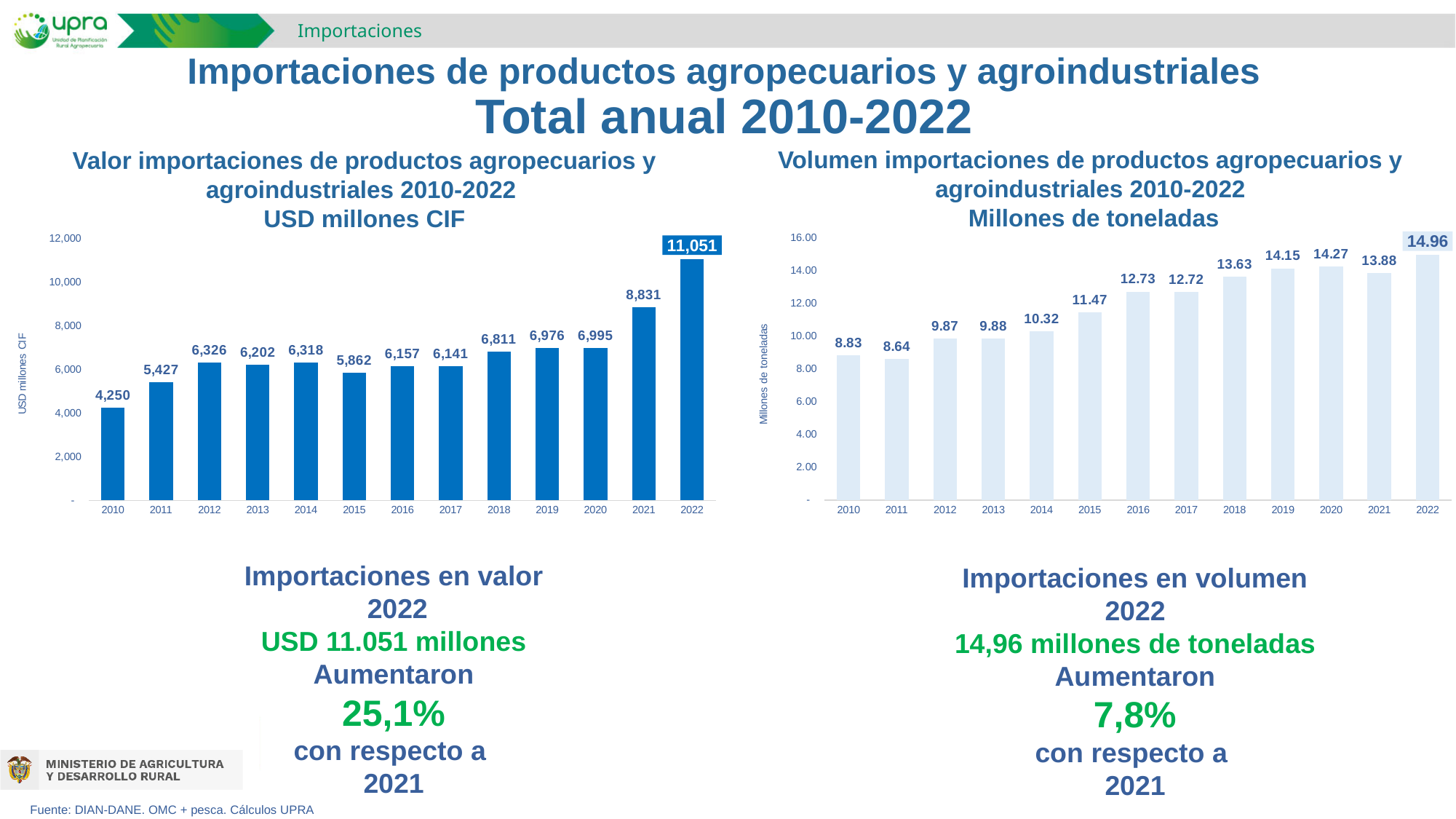
In the left chart (Valor importaciones, USD millones CIF), how many years are plotted? 13 In the left chart (Valor importaciones, USD millones CIF), which year has the lowest value? 2010 In the right chart (Volumen importaciones, Millones de toneladas), which is larger, the value for 2020 or the value for 2021? 2020 In the right chart (Volumen importaciones, Millones de toneladas), which year has the lowest value? 2011 In the right chart (Volumen importaciones, Millones de toneladas), what is the difference between the values for 2022 and 2021? 1.08 What kind of chart is the right chart (Volumen importaciones, Millones de toneladas)? Bar chart In the left chart (Valor importaciones, USD millones CIF), what is the difference between the values for 2022 and 2021? 2,220 In the left chart (Valor importaciones, USD millones CIF), which year has the highest value? 2022 In the right chart (Volumen importaciones, Millones de toneladas), do the values generally rise or fall from 2010 to 2022? Rise In the left chart (Valor importaciones, USD millones CIF), which is larger, the value for 2012 or the value for 2015? 2012 In the right chart (Volumen importaciones, Millones de toneladas), what is the value for 2016? 12.73 In the left chart (Valor importaciones, USD millones CIF), what is the value for 2010? 4,250